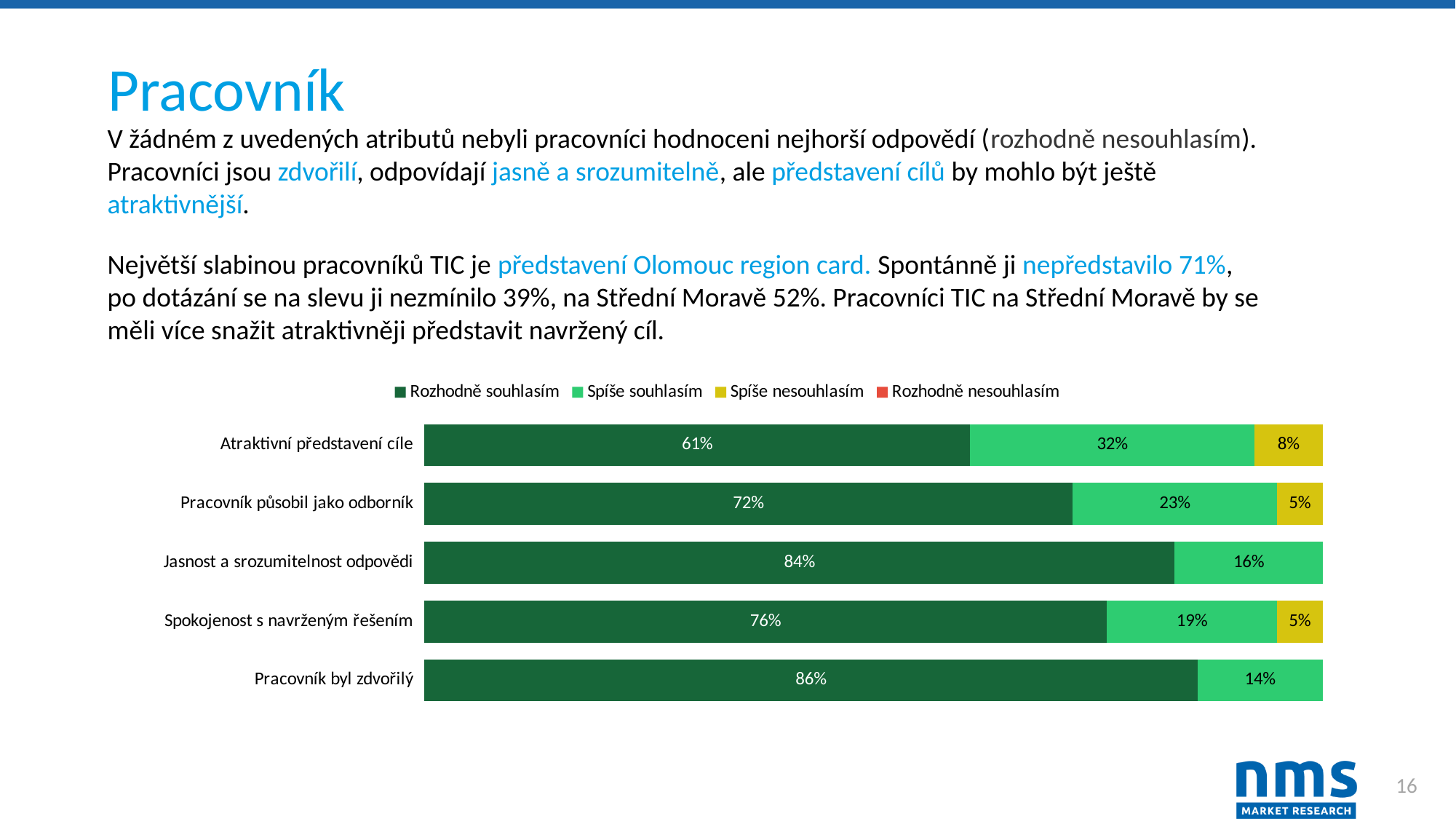
Which is larger: the 'Spíše souhlasím' value for 'Spokojenost s navrženým řešením' or for 'Jasnost a srozumitelnost odpovědi'? Spokojenost s navrženým řešením Which category has the lowest 'Rozhodně souhlasím' value? Atraktivní představení cíle What is the 'Rozhodně souhlasím' value for 'Pracovník byl zdvořilý'? 86% What is the total of the stacked bar for 'Jasnost a srozumitelnost odpovědi'? 100% What type of chart is shown on the slide? Stacked bar chart What is the 'Spíše souhlasím' value for 'Atraktivní představení cíle'? 32% What is the difference between the 'Rozhodně souhlasím' values for 'Jasnost a srozumitelnost odpovědi' and 'Pracovník působil jako odborník'? 12% What is the 'Spíše nesouhlasím' value for 'Pracovník působil jako odborník'? 5% How many categories are plotted in the chart? 5 Which legend entry is shown in red? Rozhodně nesouhlasím Which category has the highest 'Rozhodně souhlasím' value? Pracovník byl zdvořilý How many series does the legend list? 4